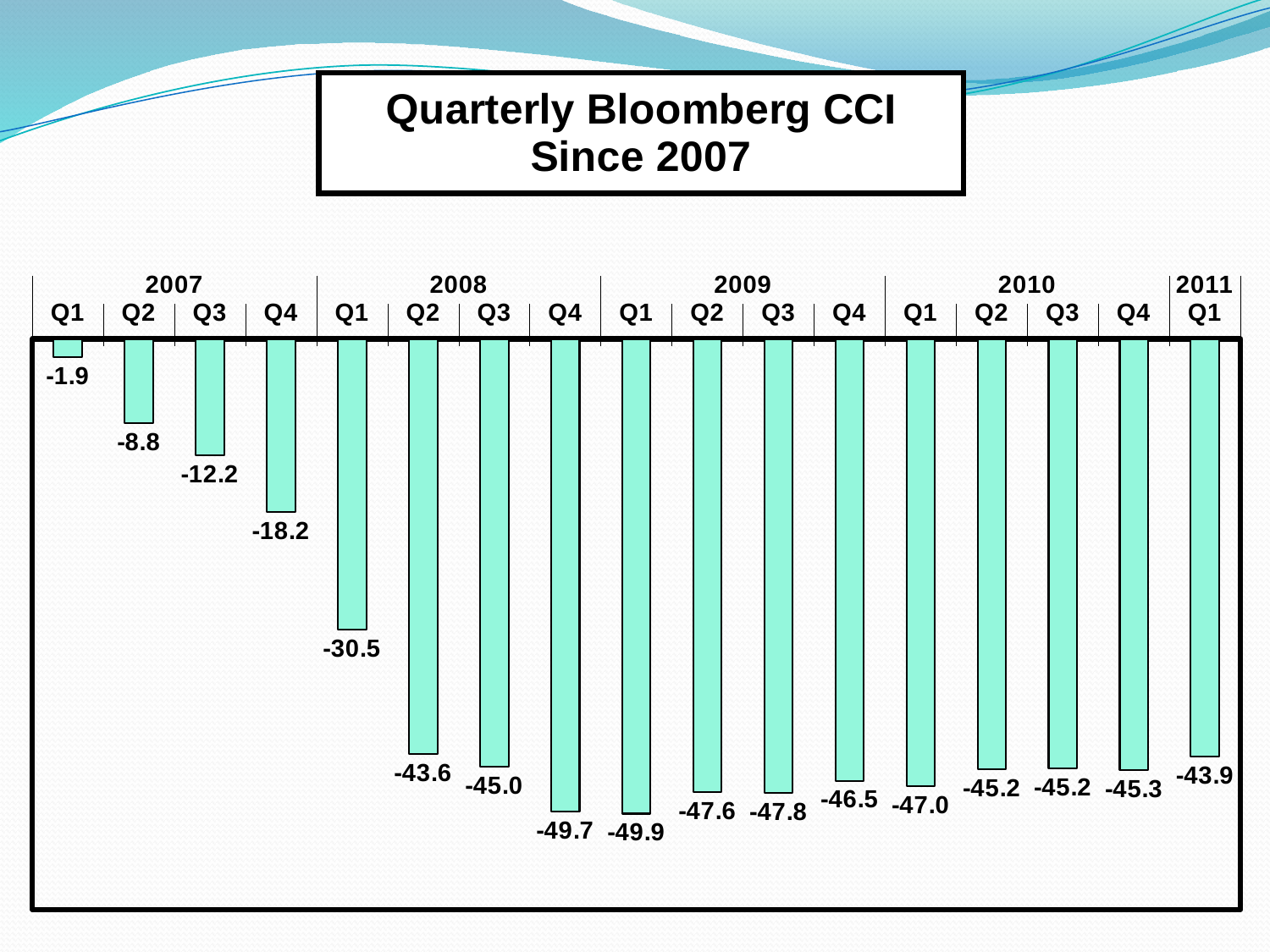
What is the Bloomberg CCI value for Q1 2007? -1.9 What is the Bloomberg CCI value for Q4 2008? -49.7 What is the difference between the Q4 2007 value and the Q1 2008 value? 12.3 What is the Bloomberg CCI value for Q1 2011? -43.9 What kind of chart is shown on the slide? Bar chart What is the Bloomberg CCI value for Q2 2010? -45.2 What is the difference between the Q2 2008 value and the Q3 2008 value? 1.4 How many quarterly bars are plotted on the chart? 17 Which quarter has the lowest Bloomberg CCI value? Q1 2009 Which is larger, the value for Q3 2007 or the value for Q4 2007? Q3 2007 Which quarter has the highest Bloomberg CCI value? Q1 2007 Do the values rise or fall across the four quarters of 2007? Fall